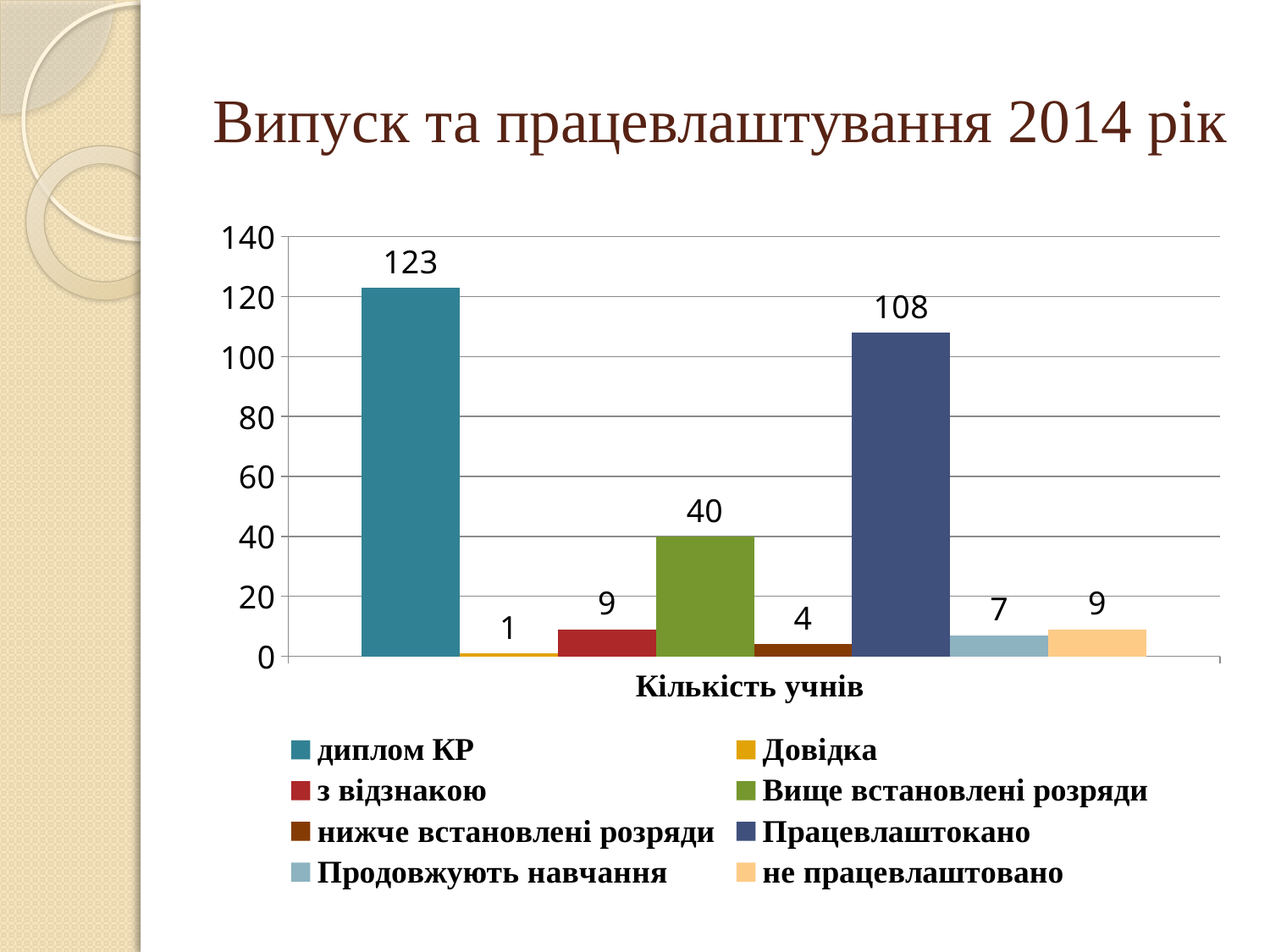
What is the value for Працевлаштокано? 108 What is the title of the slide? Випуск та працевлаштування 2014 рік What is the value for Вище встановлені розряди? 40 Which series has the lowest value? Довідка What is the value for диплом КР? 123 What is the difference between диплом КР and Працевлаштокано? 15 What is the difference between Вище встановлені розряди and нижче встановлені розряди? 36 What kind of chart is shown on the slide? bar chart Which series has the highest value? диплом КР What is the value for Довідка? 1 Which is larger, Продовжують навчання or не працевлаштовано? не працевлаштовано How many series does the legend list? 8